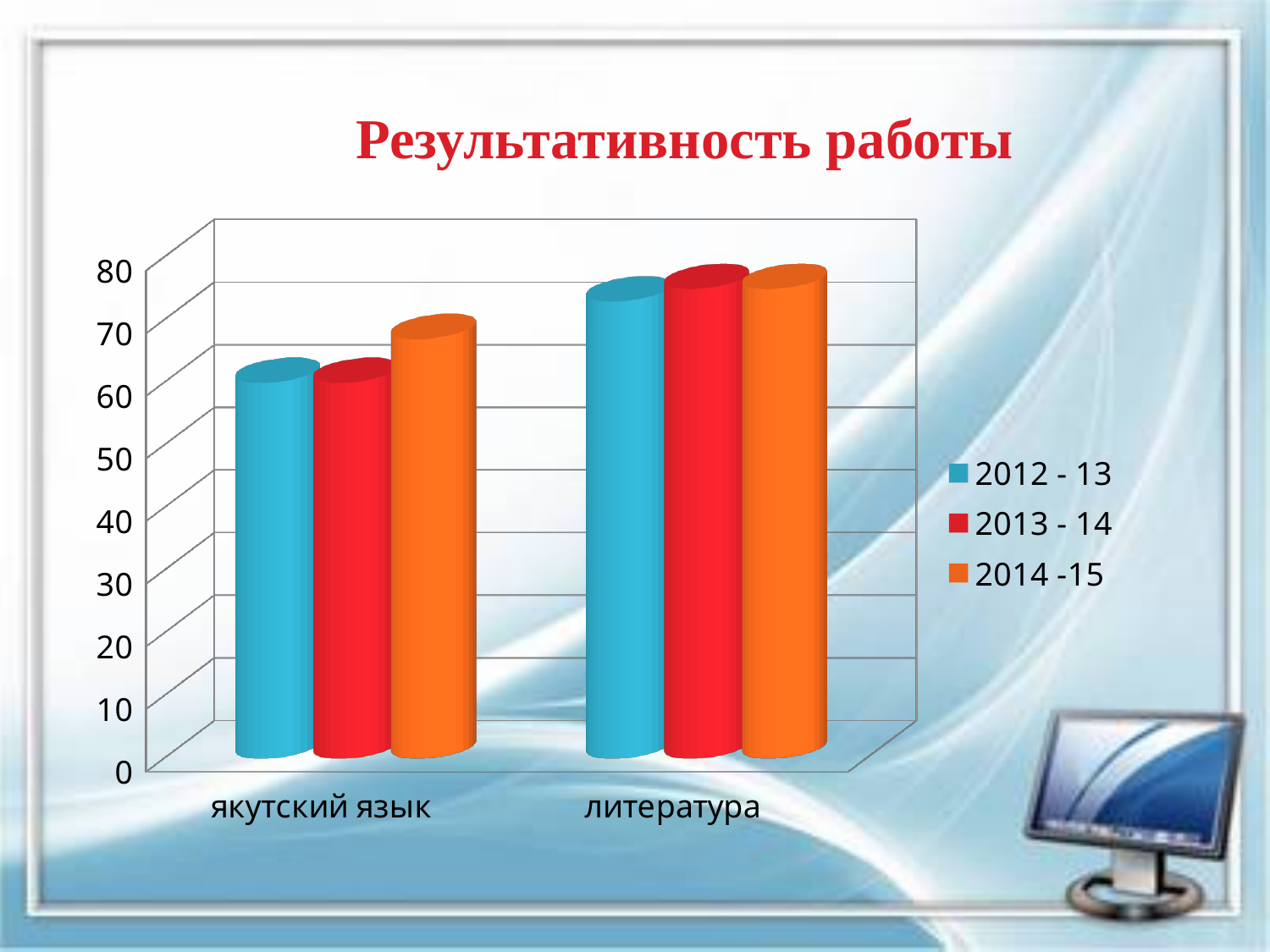
Is the value for якутский язык in 2014 -15 greater or less than 60? greater For якутский язык, is the value for 2014 -15 larger or smaller than the value for 2012 - 13? larger What is the title of the chart? Результативность работы For the 2013 - 14 series, which category has the higher value: якутский язык or литература? литература Is the value for литература in 2014 -15 greater or less than 80? less Is the value for якутский язык in 2012 - 13 greater or less than 70? less How many categories are shown on the x axis? 2 What kind of chart is shown on the slide? bar chart Which series is shown in orange in the legend? 2014 -15 For якутский язык, which series has the highest value? 2014 -15 How many series does the legend list? 3